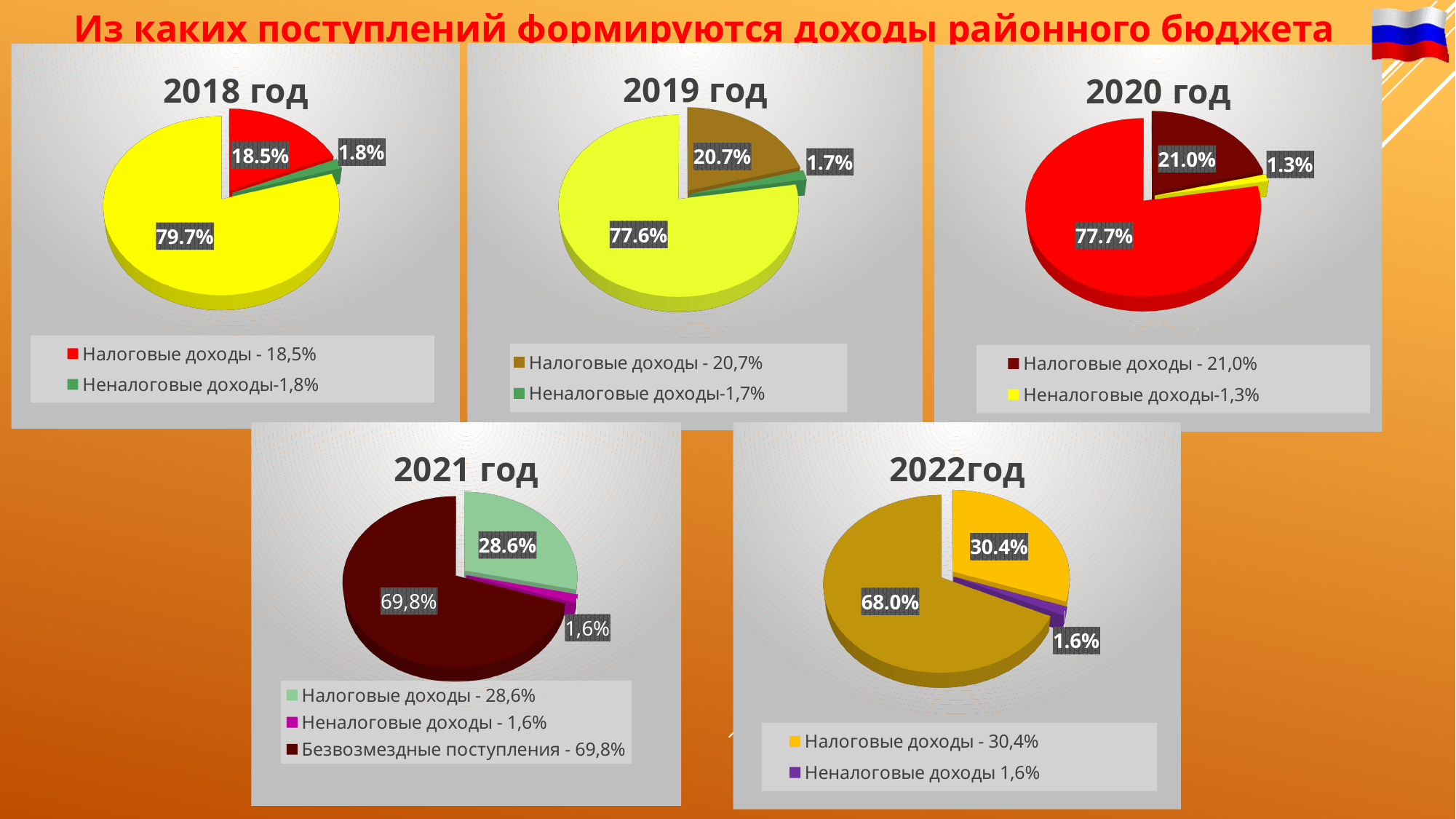
In the 2019 год chart, what is the value of the largest slice? 77.6% In the 2020 год chart, how many slices does the pie have? 3 What kind of chart is the 2019 год chart? pie chart How many charts are shown on the slide? 5 In the 2018 год chart, what is the value for Налоговые доходы? 18.5% In the 2022год chart, what is the value for Налоговые доходы? 30.4% In the 2020 год chart, what is the value for Неналоговые доходы? 1.3% In the 2021 год chart, which category has the smallest slice? Неналоговые доходы In the 2021 год chart, how many entries does the legend list? 3 In the 2021 год chart, what is the value for Безвозмездные поступления? 69,8% Which chart shows a larger value for Налоговые доходы, 2018 год or 2022год? 2022год In the 2022год chart, what is the difference between Налоговые доходы and Неналоговые доходы? 28.8%